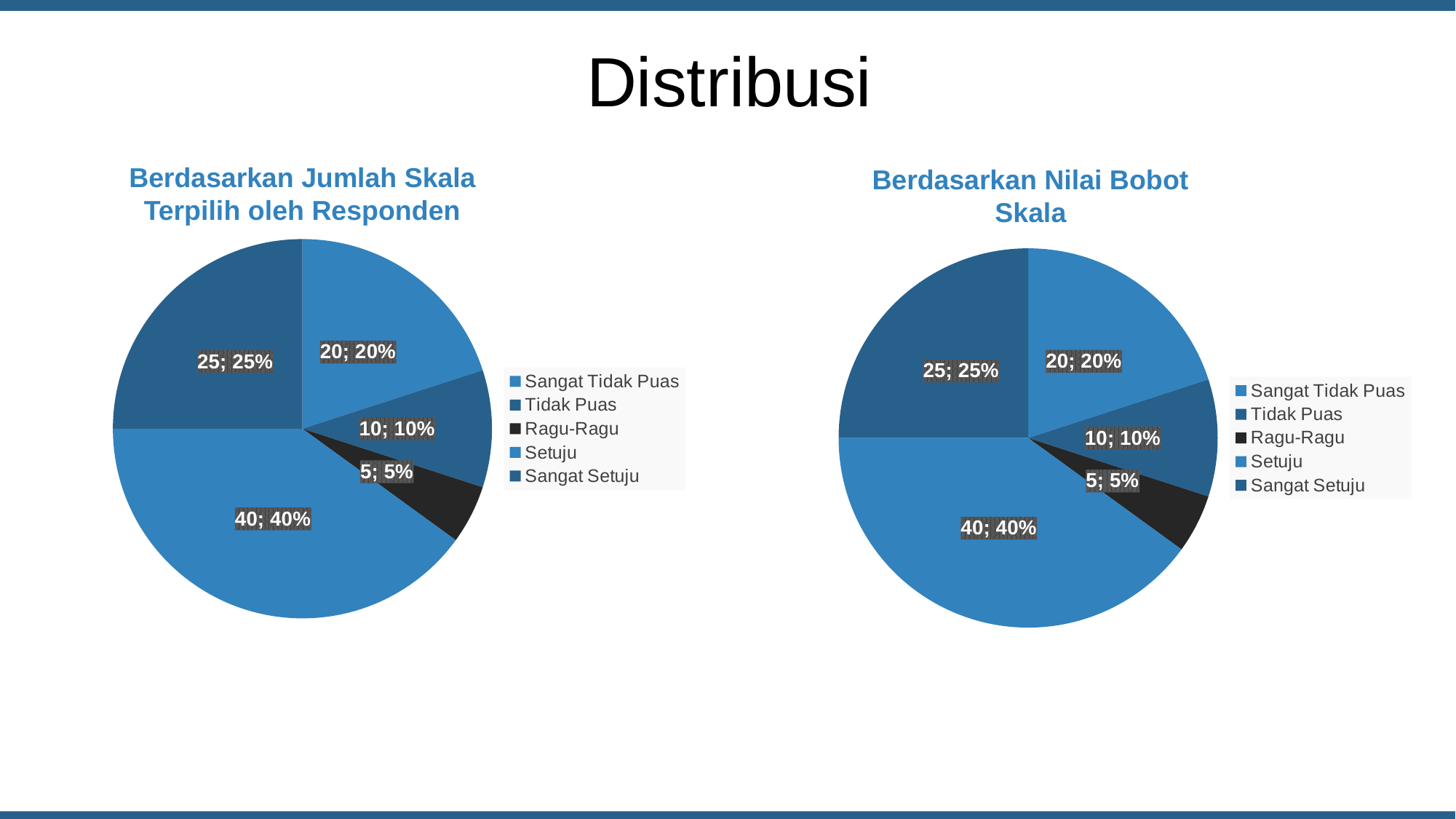
In the chart titled "Berdasarkan Jumlah Skala Terpilih oleh Responden", what percentage share does Sangat Setuju have? 25% What type of chart is the chart titled "Berdasarkan Nilai Bobot Skala"? Pie chart In the chart titled "Berdasarkan Jumlah Skala Terpilih oleh Responden", which legend entry is shown in black? Ragu-Ragu In the chart titled "Berdasarkan Nilai Bobot Skala", which is larger, Tidak Puas or Sangat Tidak Puas? Sangat Tidak Puas In the chart titled "Berdasarkan Nilai Bobot Skala", what percentage share does Sangat Tidak Puas have? 20% In the chart titled "Berdasarkan Jumlah Skala Terpilih oleh Responden", which category has the largest slice? Setuju In the chart titled "Berdasarkan Jumlah Skala Terpilih oleh Responden", what is the data label on the Setuju slice? 40; 40% In the chart titled "Berdasarkan Nilai Bobot Skala", what is the data label on the Ragu-Ragu slice? 5; 5% In the chart titled "Berdasarkan Nilai Bobot Skala", what is the value for Tidak Puas? 10 In the chart titled "Berdasarkan Jumlah Skala Terpilih oleh Responden", what is the difference between the Setuju value and the Sangat Setuju value? 15 How many categories does the legend of the chart titled "Berdasarkan Jumlah Skala Terpilih oleh Responden" list? 5 In the chart titled "Berdasarkan Nilai Bobot Skala", which category has the smallest slice? Ragu-Ragu